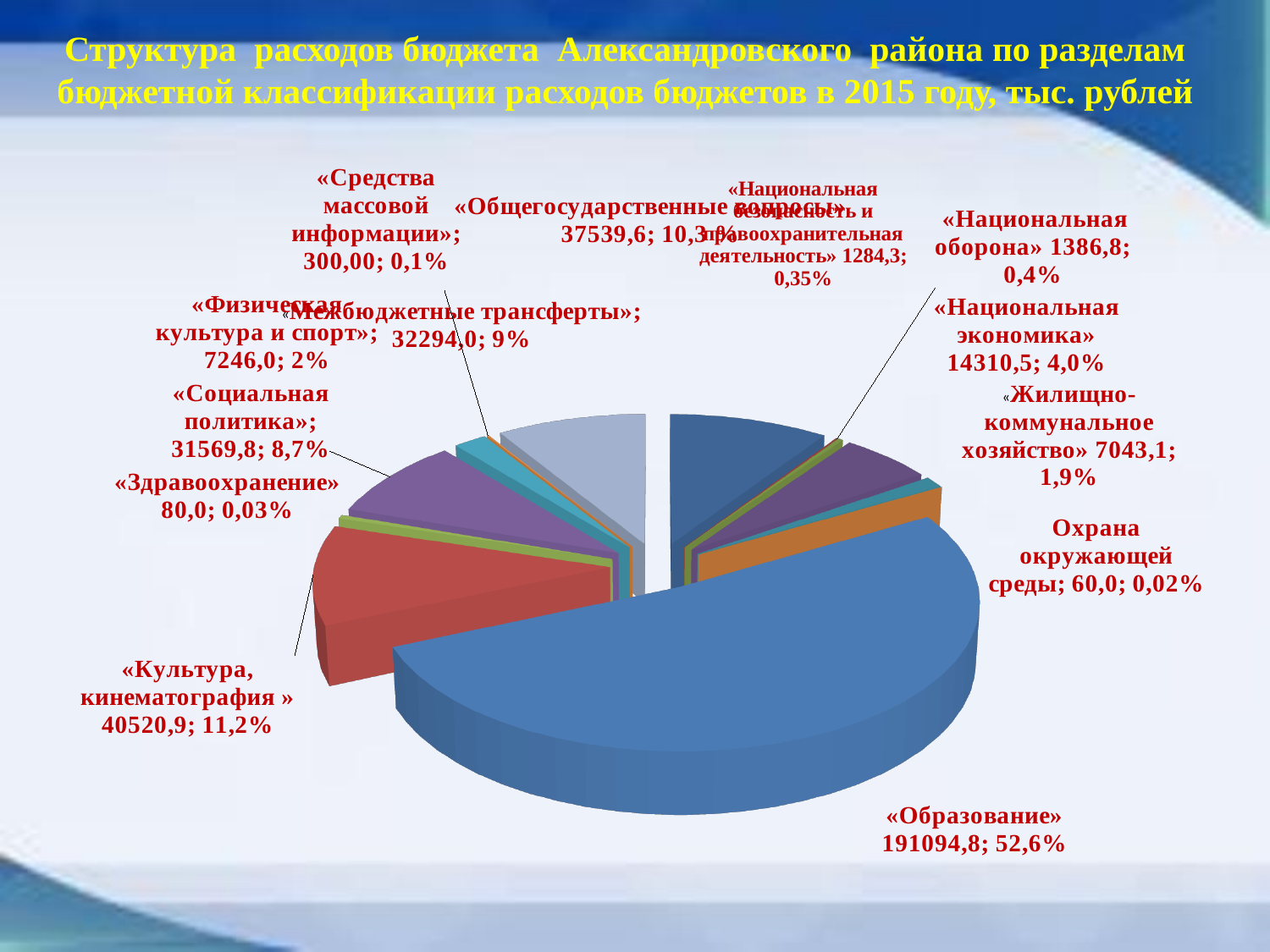
Which category has the largest share of the pie? «Образование» What percentage is shown for «Социальная политика»? 8,7% What is the value for «Культура, кинематография» in the pie chart? 40520,9 What is the value for «Национальная экономика»? 14310,5 What is the difference between the values for «Национальная оборона» and «Здравоохранение»? 1306,8 What is the value for «Образование» in the pie chart? 191094,8 What share of the pie does «Образование» account for? 52,6% What year does the chart title say the budget expenditure structure refers to? 2015 How many categories are shown in the pie chart? 13 Which category has the smallest value in the pie chart? Охрана окружающей среды Which is larger: «Межбюджетные трансферты» or «Социальная политика»? «Межбюджетные трансферты» What kind of chart is shown on the slide? Pie chart